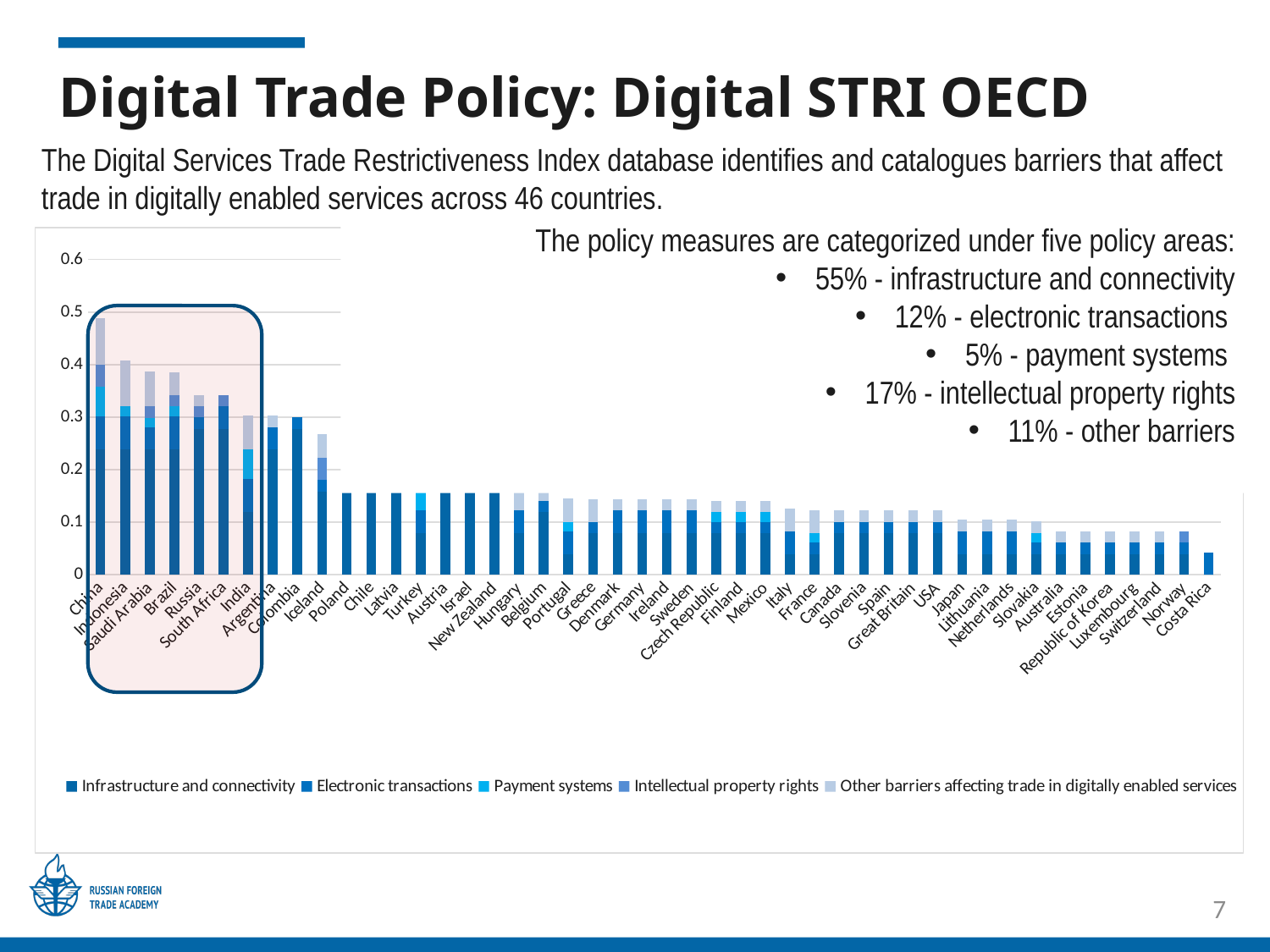
What is the first series listed in the chart legend? Infrastructure and connectivity Which country has the lowest total bar in the chart? Costa Rica What kind of chart is shown on the slide? stacked bar chart Which country has the highest total bar in the chart? China Is the total value for Indonesia greater or less than 0.3? greater Is the total value for Costa Rica greater or less than 0.1? less How many series does the chart legend list? 5 Do the total bar values generally rise or fall moving from left to right along the x axis? fall Is the total value for China greater or less than 0.4? greater How many countries are plotted on the x axis of the chart? 46 Which country has a larger total bar, Brazil or Poland? Brazil